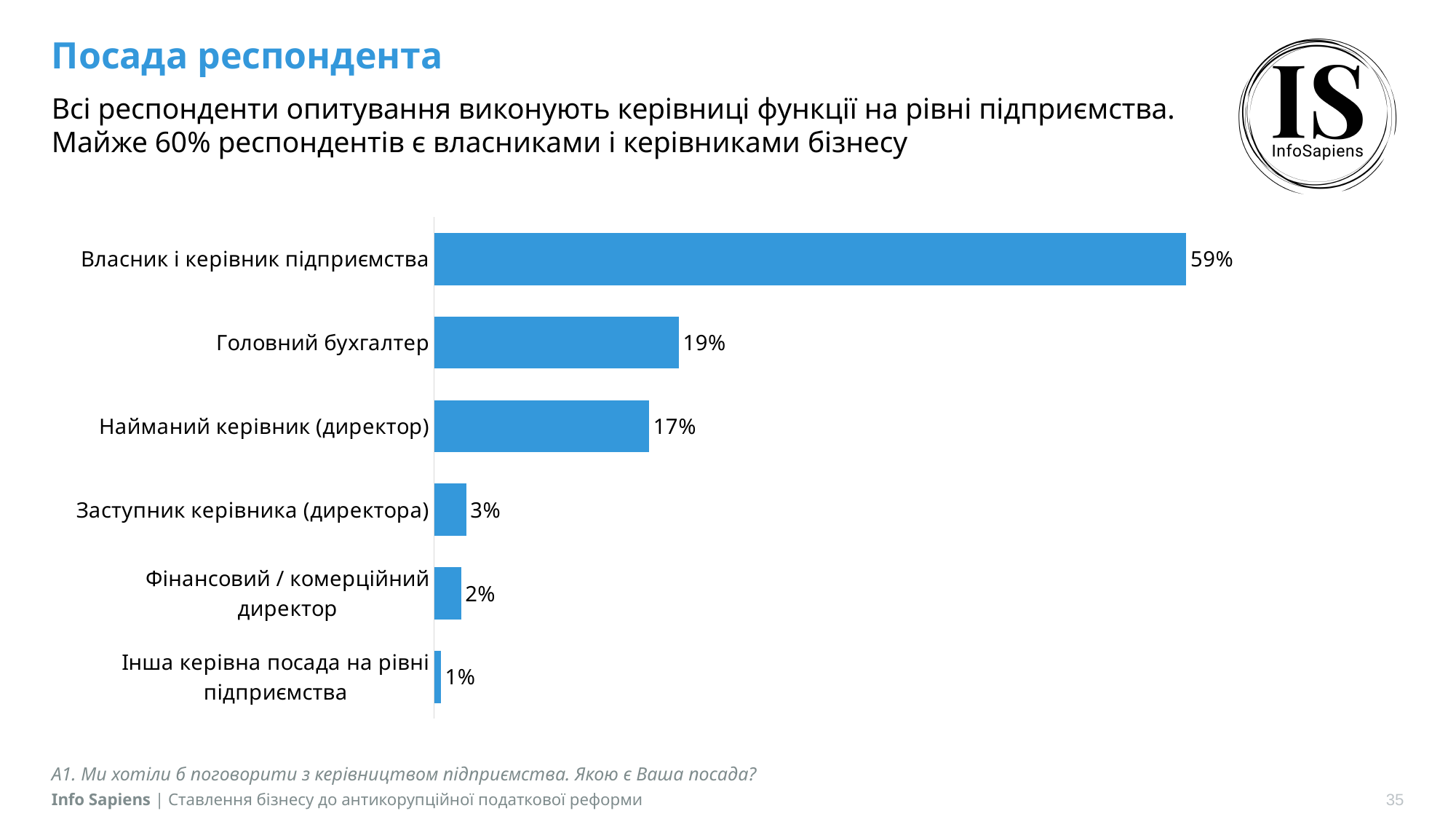
How many categories are shown in the chart? 6 What type of chart is shown on the slide? Bar chart What percentage of respondents are 'Власник і керівник підприємства'? 59% Which category has the lowest value? Інша керівна посада на рівні підприємства What is the difference between 'Головний бухгалтер' and 'Найманий керівник (директор)'? 2% What is the difference between 'Власник і керівник підприємства' and 'Головний бухгалтер'? 40% What is the value shown for 'Головний бухгалтер'? 19% Which category has the highest value? Власник і керівник підприємства What is the title of the slide? Посада респондента Which is larger: 'Заступник керівника (директора)' or 'Фінансовий / комерційний директор'? Заступник керівника (директора) What is the value shown for 'Фінансовий / комерційний директор'? 2% What is the value shown for 'Найманий керівник (директор)'? 17%